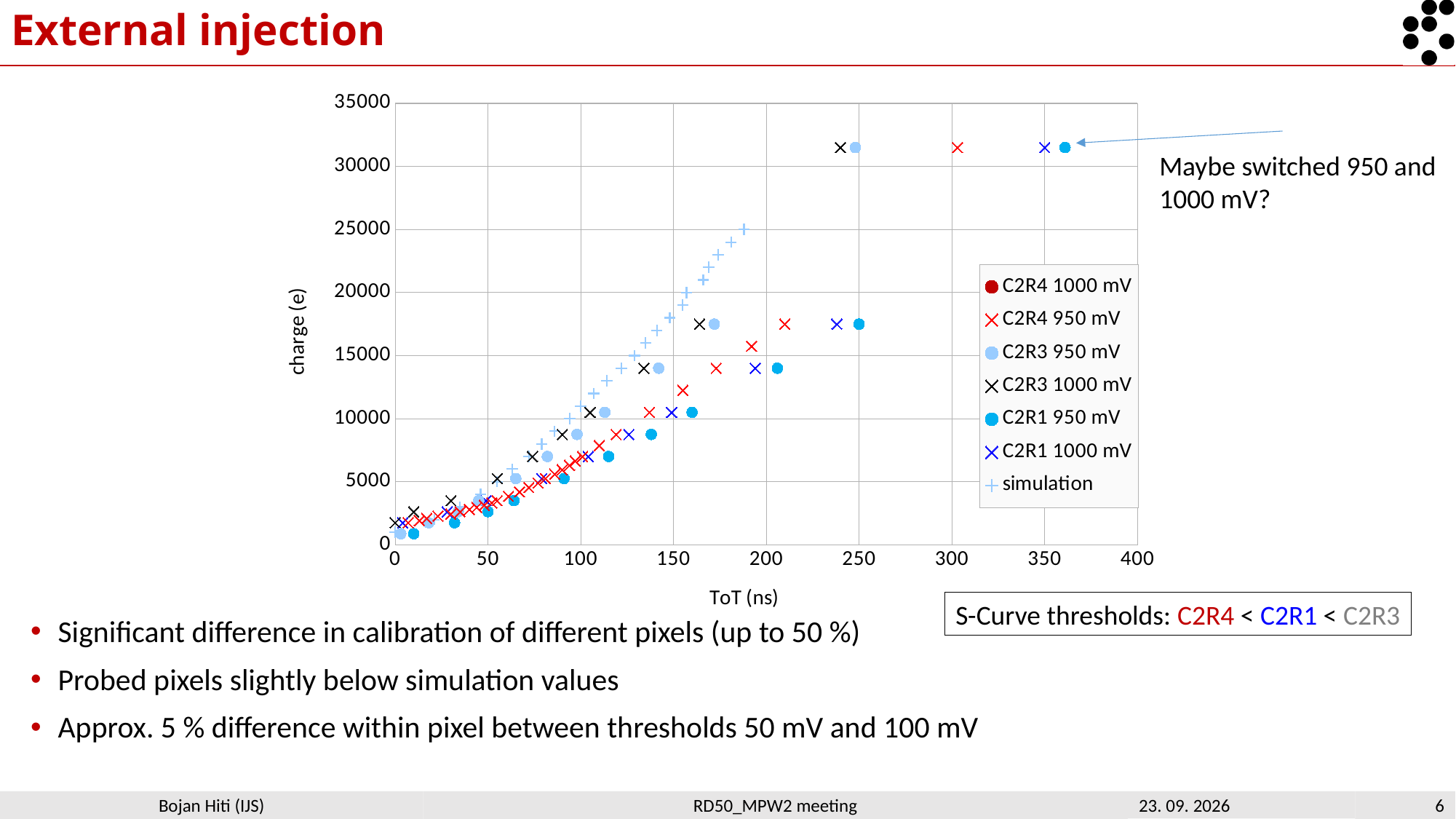
Do the charge values rise or fall as ToT increases along the x axis? rise Is the largest ToT value reached by the C2R3 1000 mV series greater or less than 200? greater Is the largest ToT value reached by the simulation series greater or less than 200? less How many series does the chart legend list? 7 Is the largest ToT value reached by the C2R1 950 mV series greater or less than 300? greater What kind of chart is shown on the slide? scatter chart At the highest charge level, which series reaches a larger ToT: C2R4 950 mV or C2R3 950 mV? C2R4 950 mV What is the label of the y axis of the chart? charge (e) What is the label of the x axis of the chart? ToT (ns) Which series in the chart is plotted with plus-sign markers? simulation